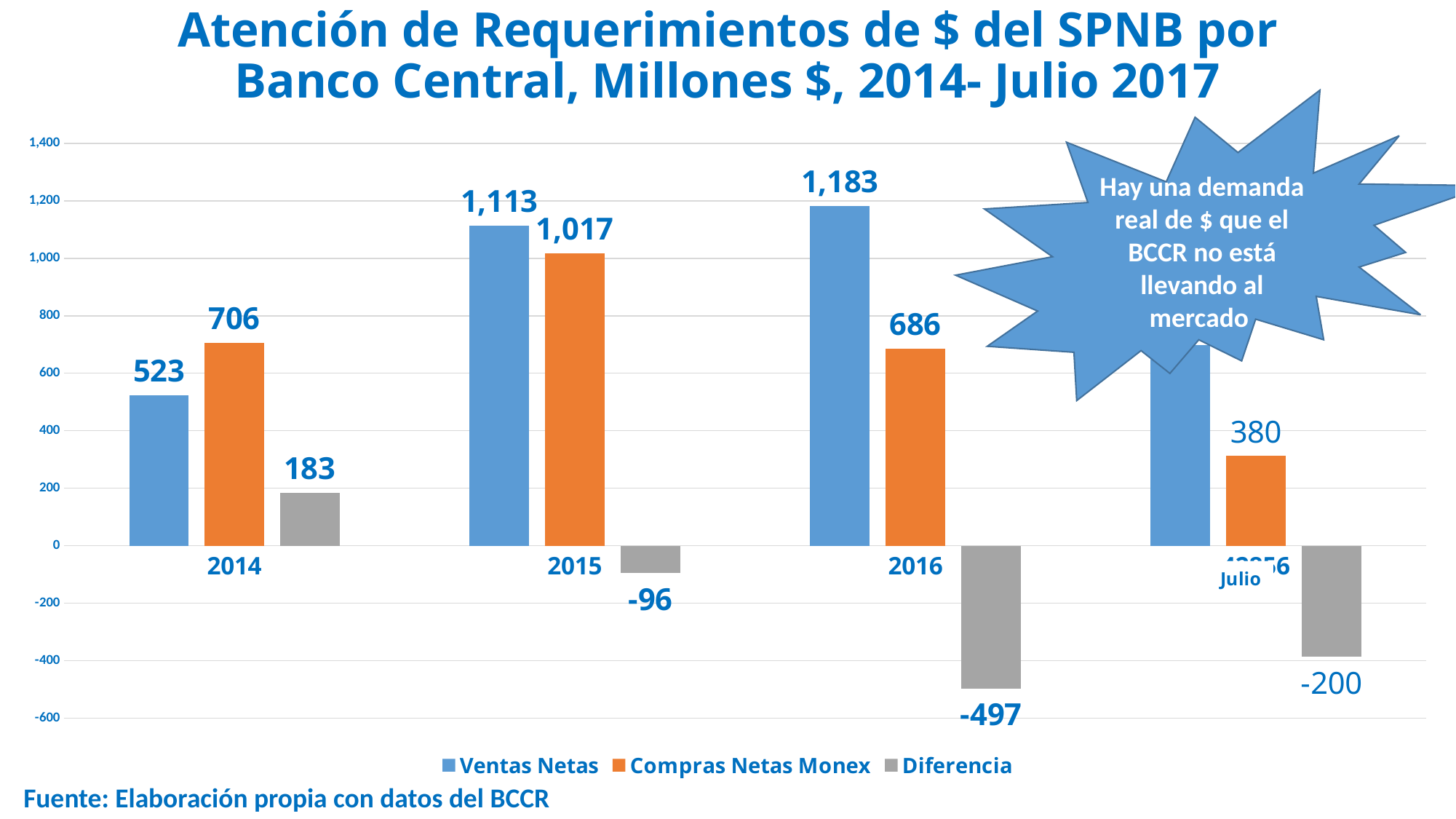
What is the difference between Compras Netas Monex and Ventas Netas in 2014? 183 In which period is the Diferencia lowest? 2016 How many time periods are shown on the x axis? 4 Does Compras Netas Monex rise or fall from 2015 to Julio 2017? Fall What is the value of Ventas Netas for 2014? 523 In which year is Ventas Netas highest? 2016 In 2015, which is larger: Ventas Netas or Compras Netas Monex? Ventas Netas What is the value of Compras Netas Monex for Julio 2017? 380 What is the Diferencia value for 2016? -497 What is the value of Compras Netas Monex for 2015? 1,017 What type of chart is shown on the slide? Bar chart How many series does the legend list? 3